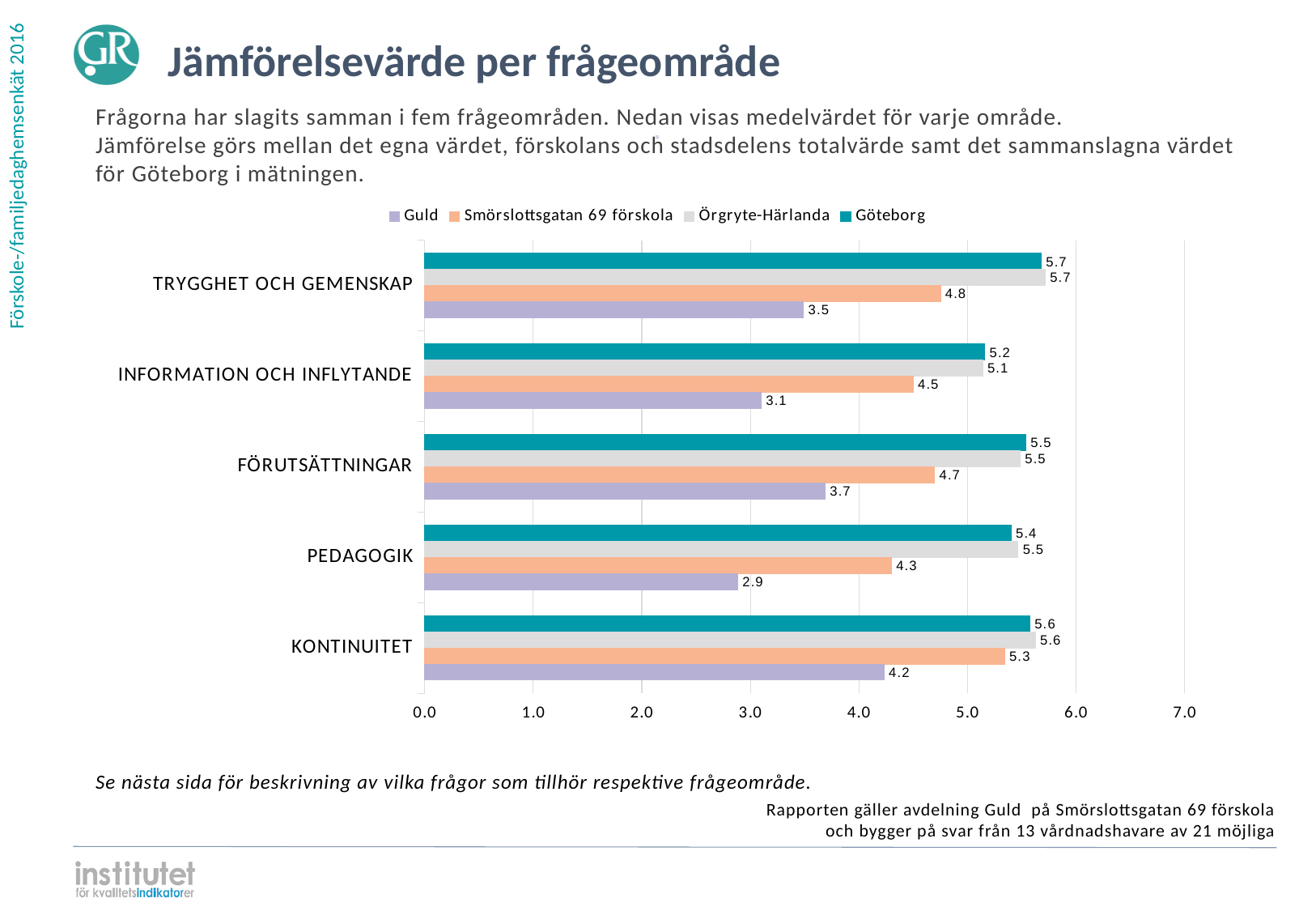
What is the value for Guld in the TRYGGHET OCH GEMENSKAP category? 3.5 Which is larger in the FÖRUTSÄTTNINGAR category: the Smörslottsgatan 69 förskola value or the Guld value? Smörslottsgatan 69 förskola In which category does the Guld series have its lowest value? PEDAGOGIK How many categories (frågeområden) are shown on the chart? 5 What is the value for Örgryte-Härlanda in the INFORMATION OCH INFLYTANDE category? 5.1 In which category does the Guld series have its highest value? KONTINUITET What is the difference between the Göteborg value and the Guld value in the TRYGGHET OCH GEMENSKAP category? 2.2 How many series does the legend list? 4 What is the value for Smörslottsgatan 69 förskola in the KONTINUITET category? 5.3 What is the value for Göteborg in the PEDAGOGIK category? 5.4 What kind of chart is shown on the slide? Bar chart Is the value for Guld in the KONTINUITET category greater or less than 4.0? greater